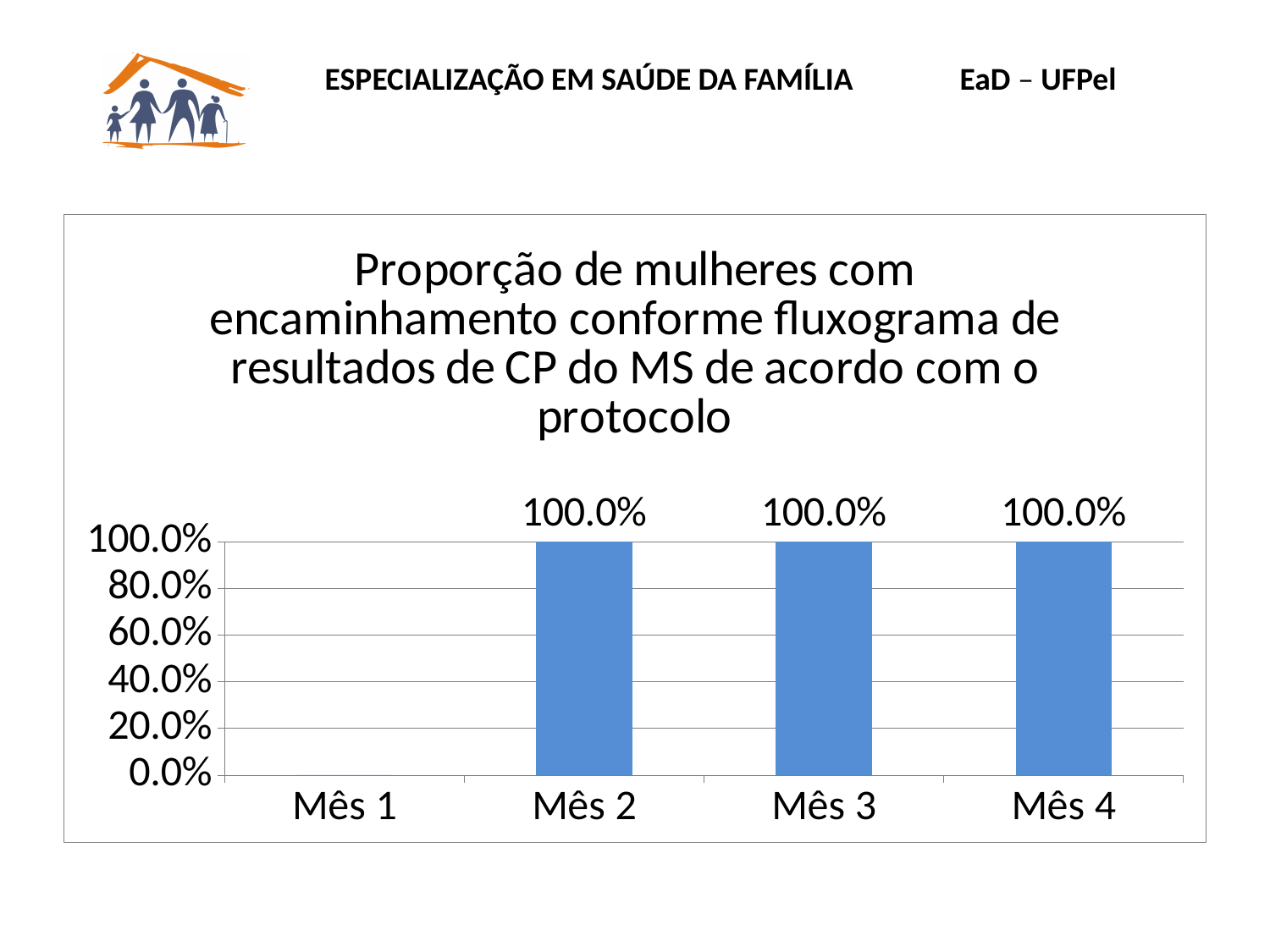
What is the value for Mês 3? 100.0% What is the value for Mês 4? 100.0% What is the difference between the values for Mês 2 and Mês 4? 0.0% What is the highest tick value shown on the y axis? 100.0% What kind of chart is shown on the slide? Bar chart Do the values change between Mês 2 and Mês 4? No, they stay at 100.0% Which is larger, the value for Mês 1 or the value for Mês 2? Mês 2 Which month has the lowest value? Mês 1 How many months (categories) are shown on the x axis? 4 What is the value for Mês 2? 100.0% Which month has no bar displayed in the chart? Mês 1 Is the value for Mês 3 greater or less than 80.0%? greater